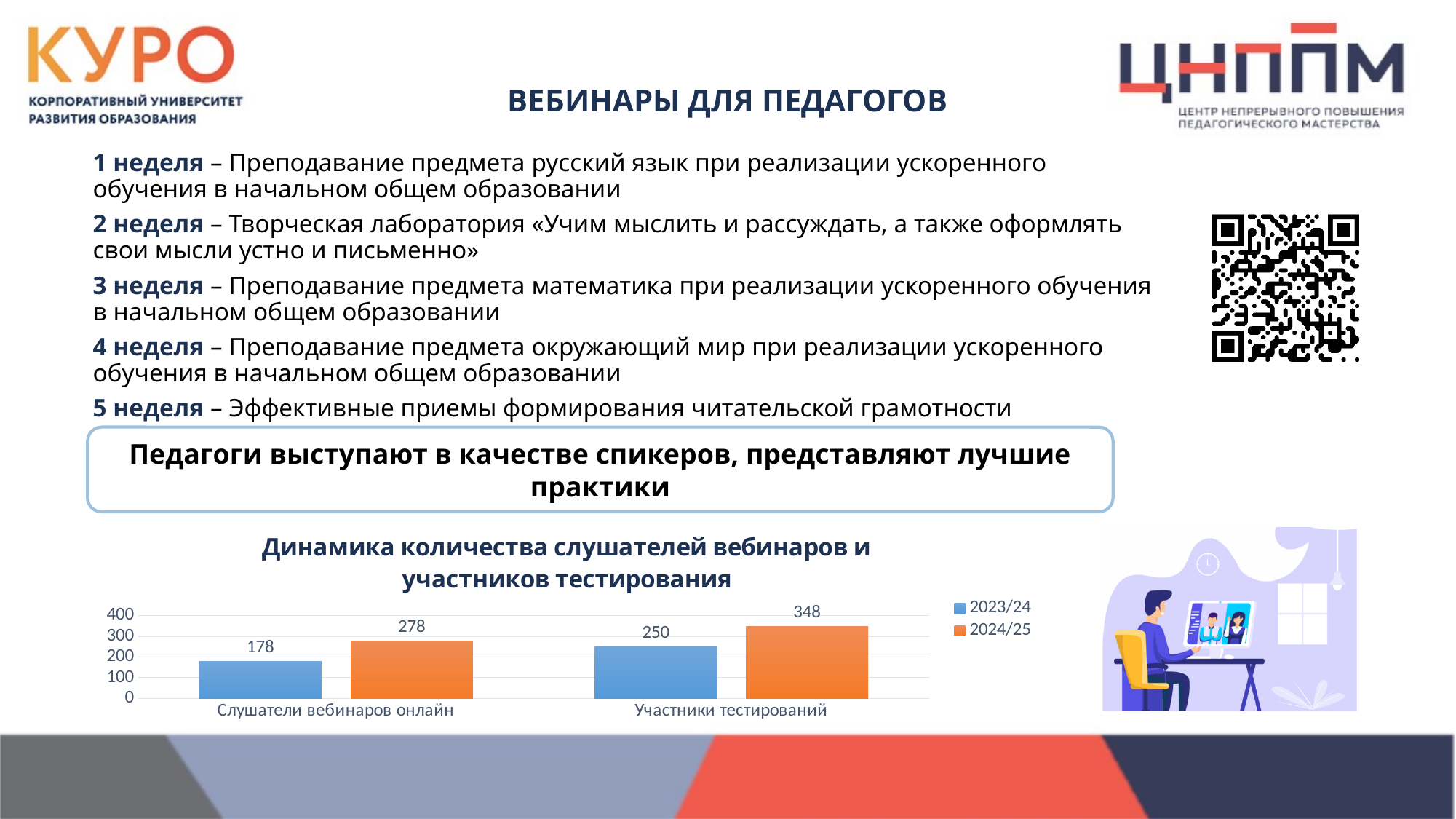
Which is larger: the 2023/24 value for 'Участники тестирований' or the 2024/25 value for 'Слушатели вебинаров онлайн'? 2024/25 value for Слушатели вебинаров онлайн How many series does the legend list? 2 What is the value for 2023/24 in the 'Слушатели вебинаров онлайн' category? 178 What is the difference between the 2024/25 and 2023/24 values for 'Участники тестирований'? 98 What is the value for 2023/24 in the 'Участники тестирований' category? 250 What is the value for 2024/25 in the 'Слушатели вебинаров онлайн' category? 278 What is the difference between the 2024/25 and 2023/24 values for 'Слушатели вебинаров онлайн'? 100 What kind of chart is shown on the slide? Bar chart How many categories are shown on the x axis? 2 Which category has the highest value for the 2024/25 series? Участники тестирований What is the value for 2024/25 in the 'Участники тестирований' category? 348 Which category has the lowest value for the 2023/24 series? Слушатели вебинаров онлайн